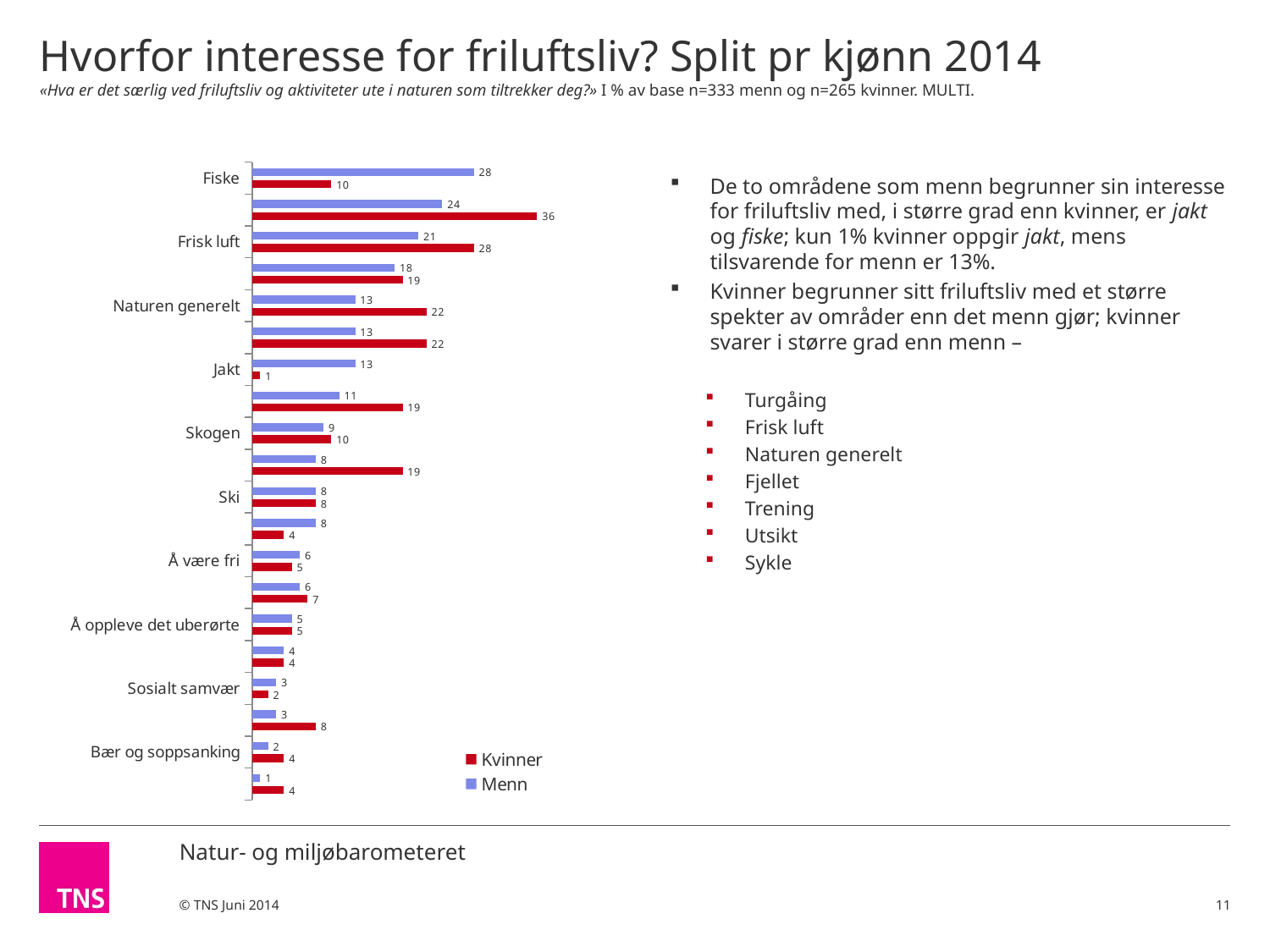
What type of chart is shown on the slide? Bar chart What is the value for Kvinner in the Skogen category? 10 Which category has the highest value for Menn? Fiske What is the value for Kvinner in the Jakt category? 1 How many series does the legend list? 2 What is the value for Kvinner in the Sosialt samvær category? 2 What is the difference between the Menn and Kvinner values for Fiske? 18 What is the value for Menn in the Fiske category? 28 What is the value for Kvinner in the Frisk luft category? 28 For Jakt, which series has the larger value, Menn or Kvinner? Menn What is the difference between the Kvinner and Menn values for Naturen generelt? 9 What is the value for Menn in the Naturen generelt category? 13